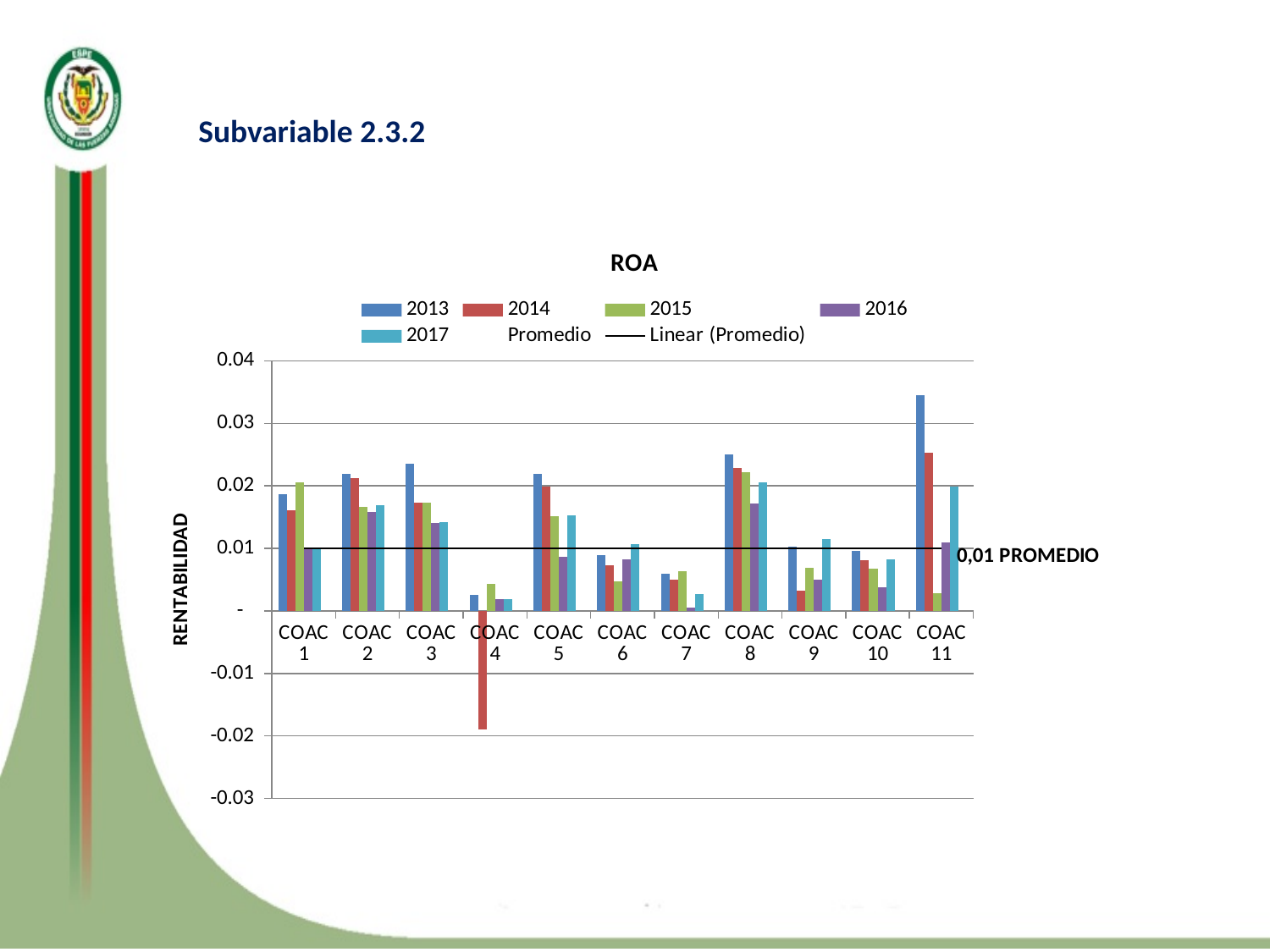
What is the title of the chart? ROA Is the 2013 value for COAC 7 greater or less than 0.01? less Which category has the highest 2013 value in the chart? COAC 11 Is the 2013 value for COAC 11 greater or less than 0.03? greater Which category has the lowest 2014 value in the chart? COAC 4 Which has the larger 2013 value, COAC 8 or COAC 7? COAC 8 How many entries does the chart legend list? 7 What value does the horizontal PROMEDIO line mark on the chart? 0,01 What type of chart is shown on the slide? bar chart How many categories (COAC) are shown on the x axis of the chart? 11 Is the 2014 value for COAC 4 greater or less than -0.01? less What is the label of the vertical axis of the chart? RENTABILIDAD